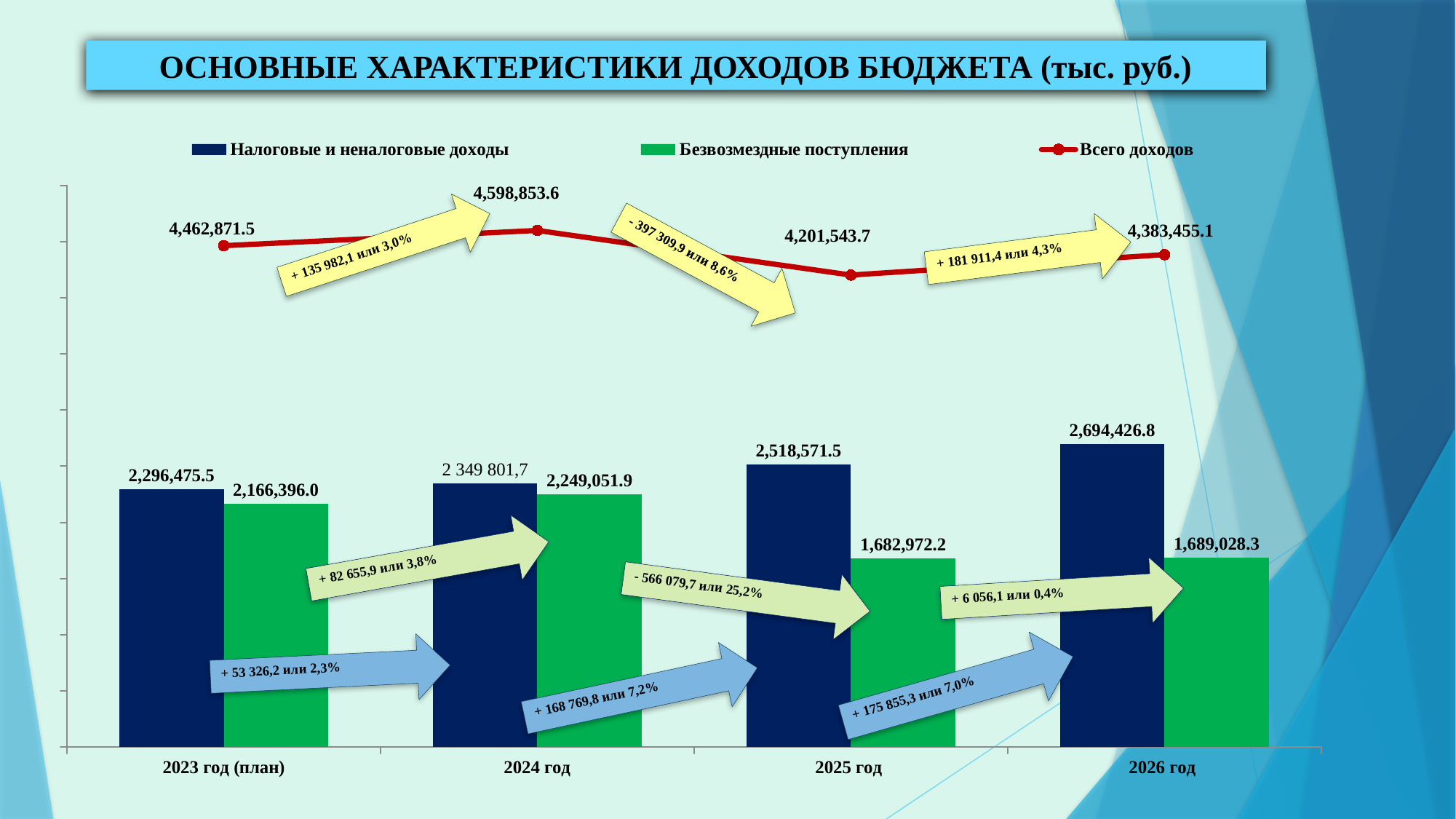
For 2025 год, which is larger: Налоговые и неналоговые доходы or Безвозмездные поступления? Налоговые и неналоговые доходы How many years are shown on the x axis? 4 What kind of chart is shown on the slide? Combined bar and line chart How many series does the legend list? 3 What is the value of Всего доходов for 2026 год? 4,383,455.1 What is the difference between Всего доходов in 2024 год and 2023 год (план)? 135,982.1 Do the values of Налоговые и неналоговые доходы rise or fall from 2023 год (план) to 2026 год? Rise In which year is Налоговые и неналоговые доходы the highest? 2026 год What is the value of Безвозмездные поступления for 2025 год? 1,682,972.2 In which year is Всего доходов the highest? 2024 год In which year is Всего доходов the lowest? 2025 год What is the value of Налоговые и неналоговые доходы for 2023 год (план)? 2,296,475.5